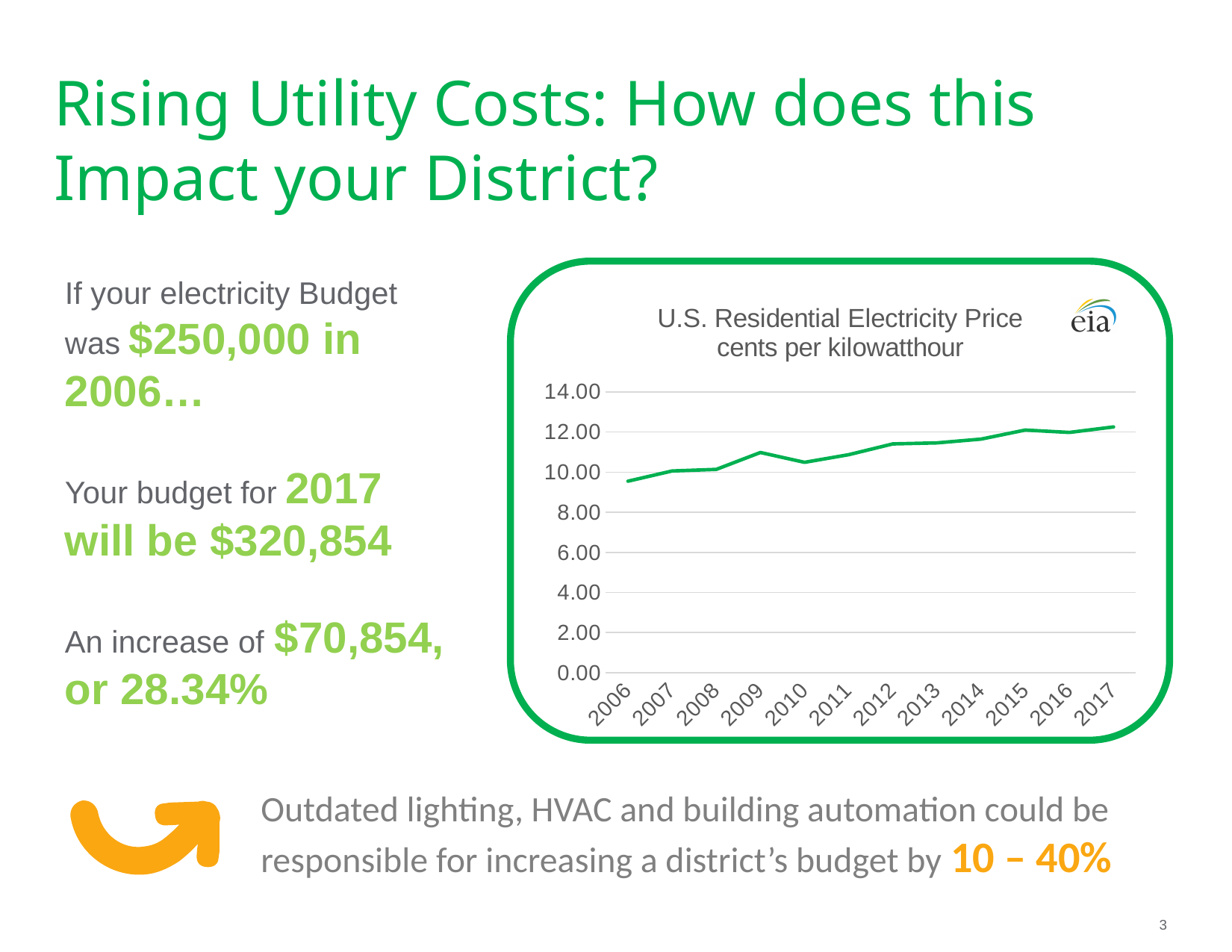
Is the value for 2006 greater or less than 10.00? less What is the unit of measurement given in the chart title? cents per kilowatthour How many years are plotted along the x axis of the chart? 12 Is the value for 2012 greater or less than 12.00? less Which year has the higher electricity price, 2006 or 2017? 2017 Which year has the higher electricity price, 2009 or 2010? 2009 Is the value for 2009 greater or less than 10.00? greater What is the title of the chart? U.S. Residential Electricity Price cents per kilowatthour What kind of chart is shown on the slide? line chart Which year has the lowest residential electricity price in the chart? 2006 Do the electricity prices generally rise or fall from 2006 to 2017? rise